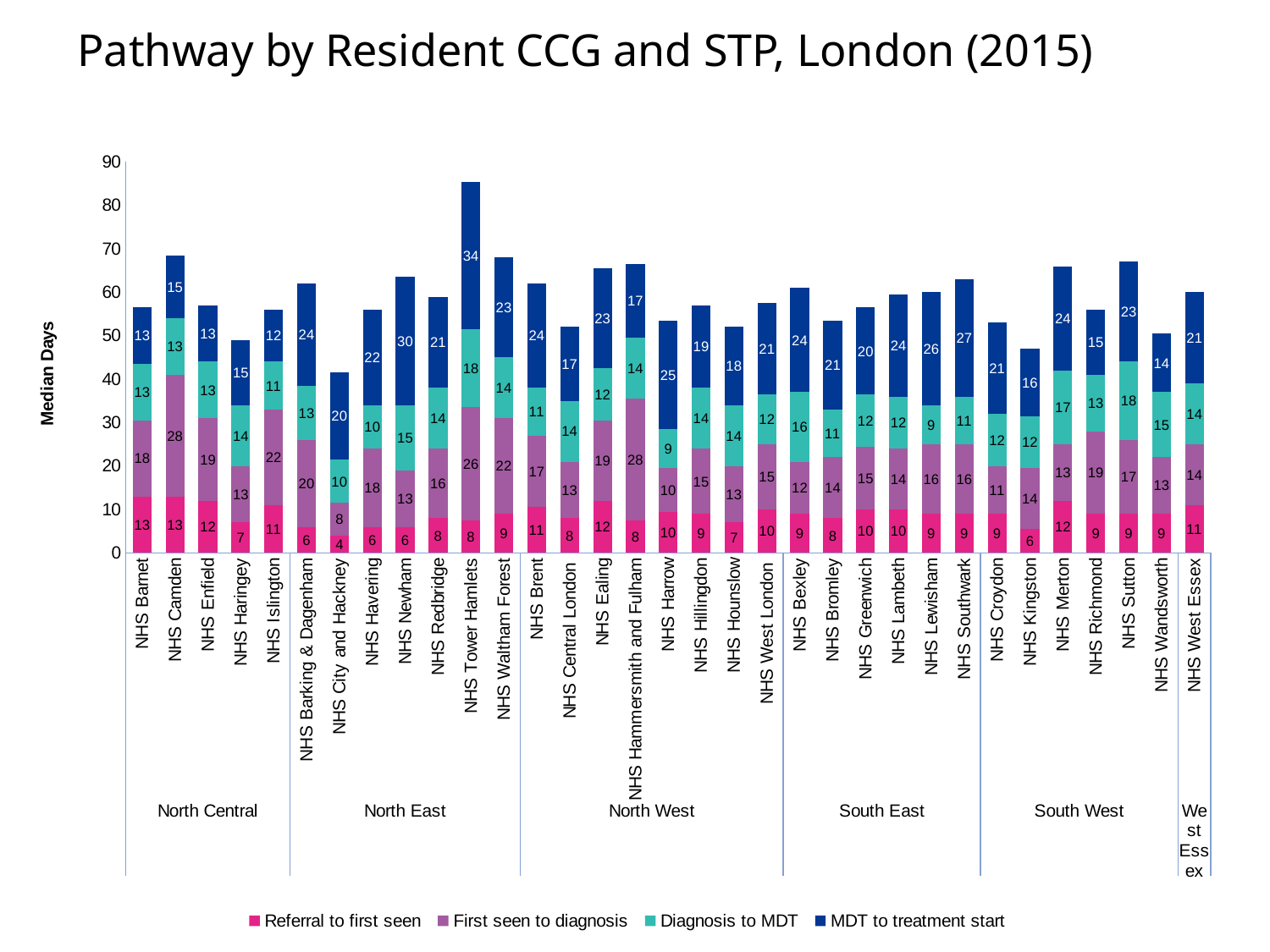
Which is larger: the 'First seen to diagnosis' value for NHS Hammersmith and Fulham or for NHS Harrow? NHS Hammersmith and Fulham Which CCG has the tallest stacked bar overall? NHS Tower Hamlets What is the 'First seen to diagnosis' value for NHS Camden? 28 What is the difference between the 'MDT to treatment start' values for NHS Newham and NHS Haringey? 15 What is the total of the stacked bar for NHS Tower Hamlets? 86 Which CCG has the shortest stacked bar overall? NHS City and Hackney What kind of chart is shown on the slide? Stacked bar chart How many series does the legend list? 4 What is the 'MDT to treatment start' value for NHS Tower Hamlets? 34 What is the 'Diagnosis to MDT' value for NHS Sutton? 18 What is the label on the vertical axis? Median Days What is the 'Referral to first seen' value for NHS City and Hackney? 4